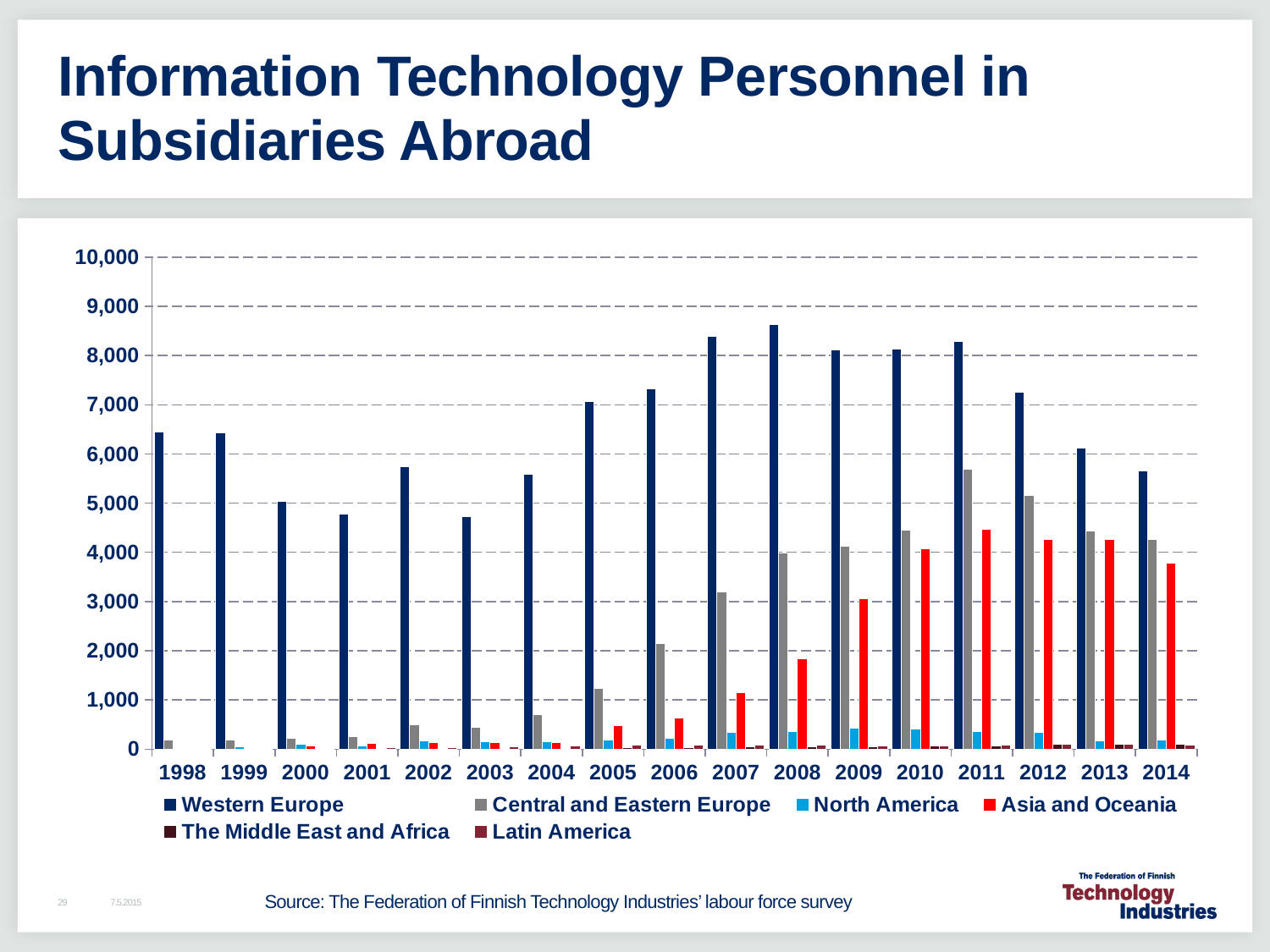
How many years are shown on the x axis? 17 Does the Asia and Oceania value rise or fall from 2005 to 2011? rise Is the Western Europe value for 2008 greater or less than 8,000? greater Is the Central and Eastern Europe value for 2011 greater or less than 5,000? greater What kind of chart is shown on the slide? bar chart Is the Western Europe value for 2003 greater or less than 5,000? less How many series does the legend list? 6 In which year is the Western Europe value highest? 2008 In which year is the Central and Eastern Europe value highest? 2011 Which colour represents Asia and Oceania in the legend? red In 2012, which is larger: Central and Eastern Europe or Asia and Oceania? Central and Eastern Europe